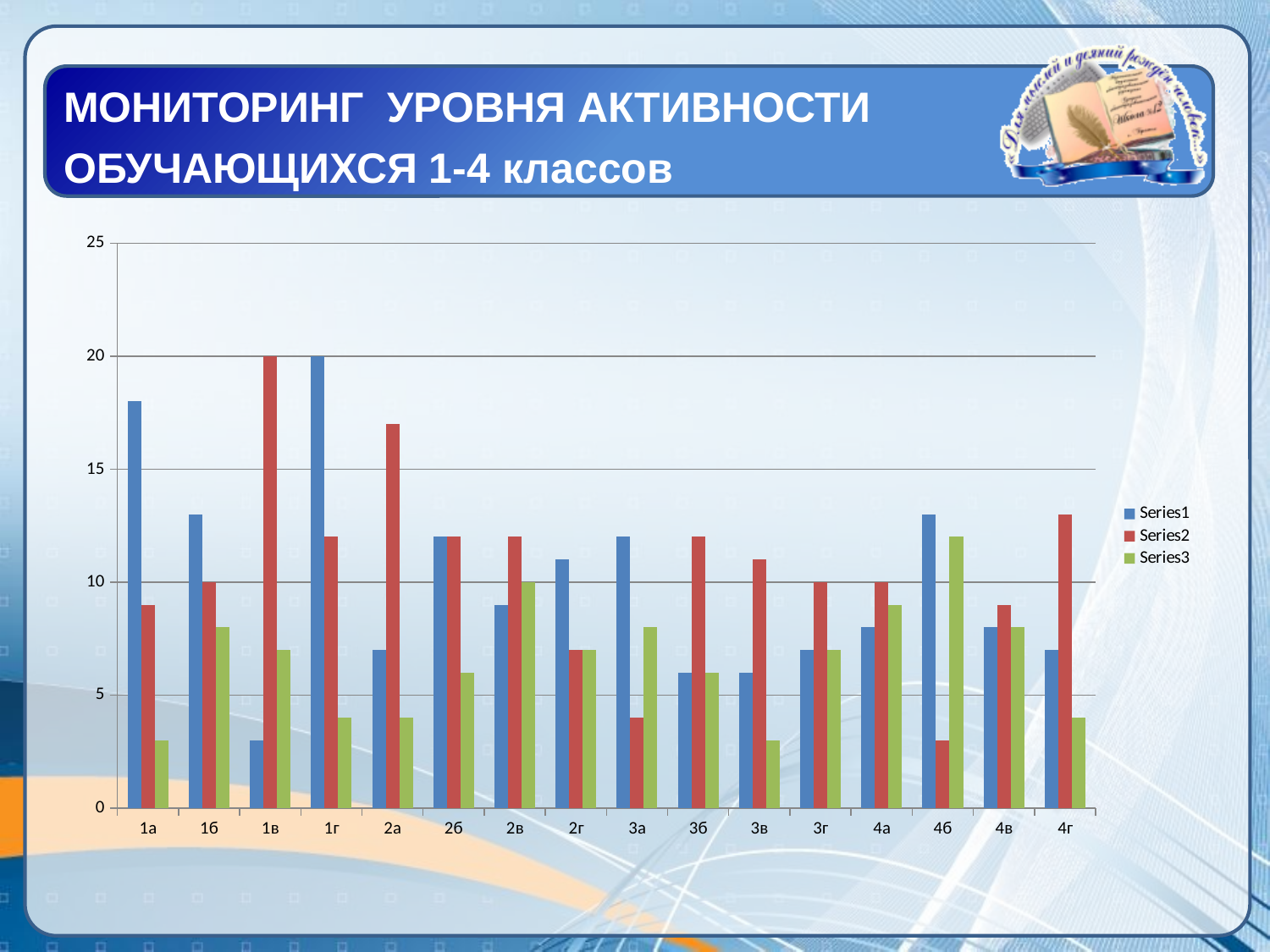
How many series does the legend list? 3 Is the value of Series2 for class 4б greater or less than 5? less For class 1в, which is larger: Series1 or Series2? Series2 Is the value of Series1 for class 1а greater or less than 15? greater Is the value of Series3 for class 4б greater or less than 10? greater For which class is Series2 highest? 1в For which class is Series3 highest? 4б How many class categories are shown on the x axis? 16 What is the value of Series1 for class 1г? 20 What is the value of Series3 for class 2в? 10 What is the value of Series2 for class 1в? 20 What kind of chart is shown on the slide? bar chart